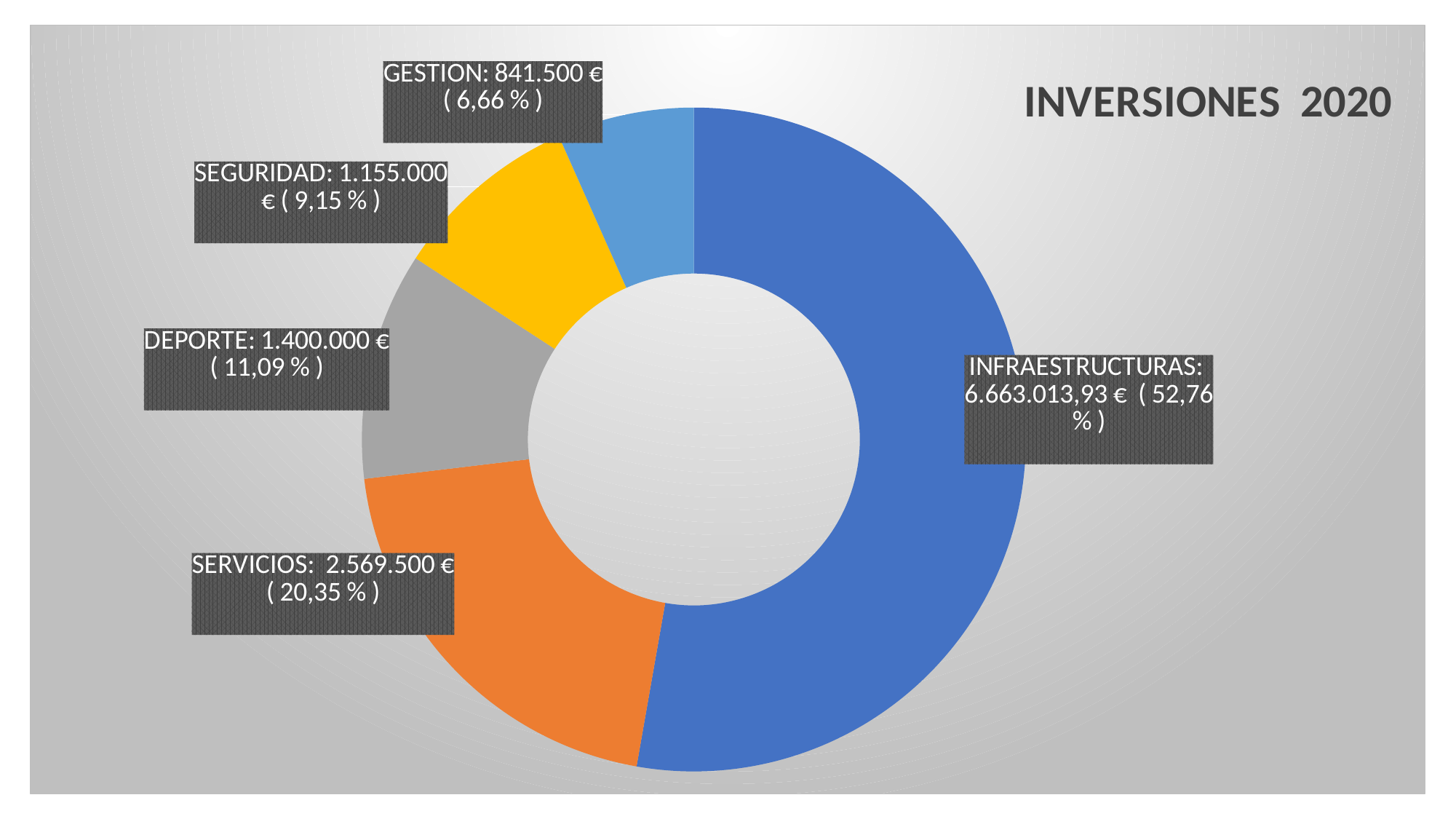
What percentage share does INFRAESTRUCTURAS have? 52,76 % Which labeled category has the largest value? INFRAESTRUCTURAS What percentage share does SEGURIDAD have? 9,15 % Which is larger, the value for SEGURIDAD or the value for GESTION? SEGURIDAD What is the title of the chart? INVERSIONES 2020 What kind of chart is shown on the slide? doughnut chart What is the value shown for GESTION? 841.500 € What is the value shown for INFRAESTRUCTURAS? 6.663.013,93 € What is the value shown for SERVICIOS? 2.569.500 € What is the value shown for DEPORTE? 1.400.000 € Which labeled category has the smallest value? GESTION What is the difference between the values for SERVICIOS and DEPORTE? 1.169.500 €